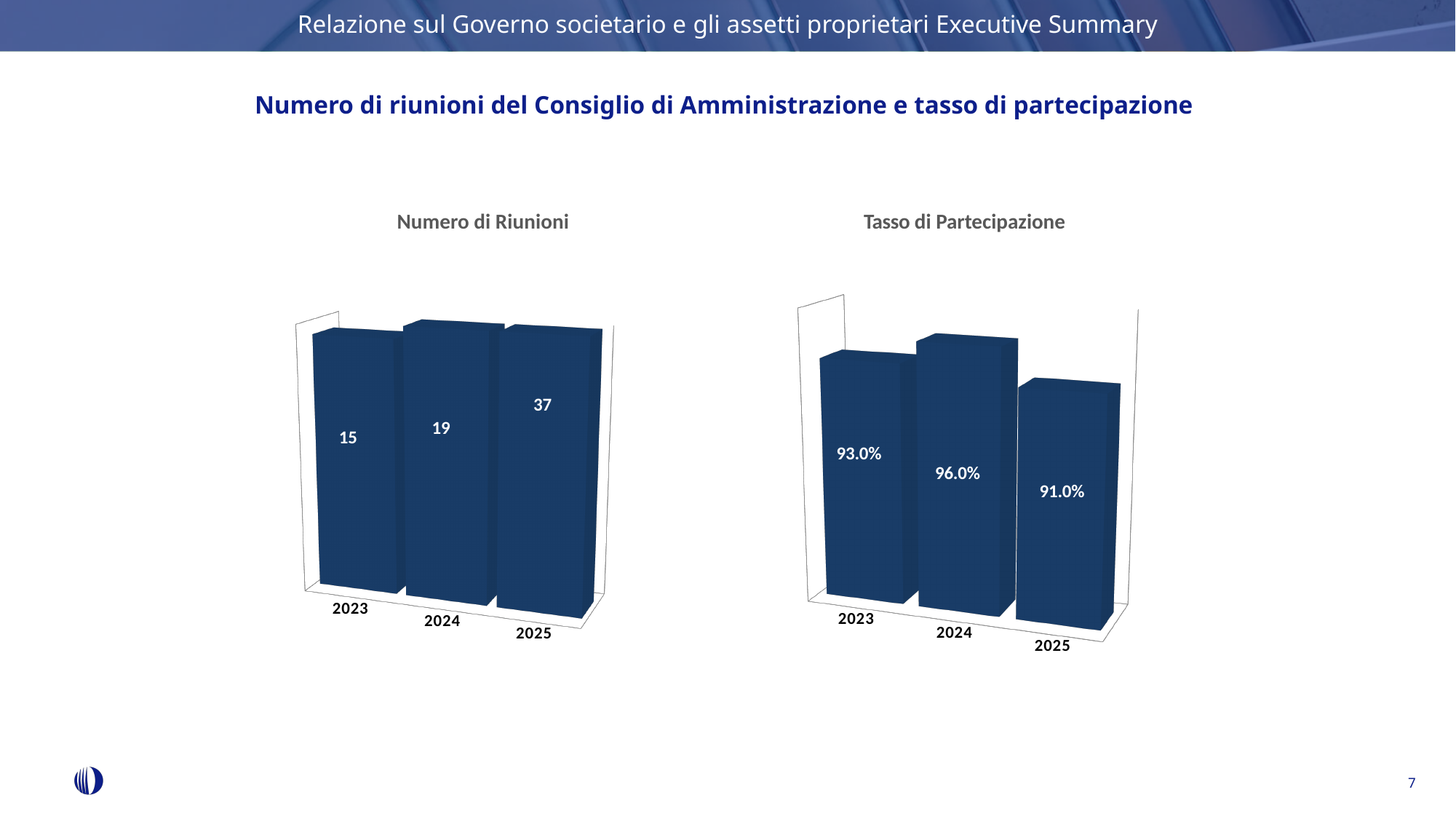
In the 'Numero di Riunioni' chart, what is the difference between the values for 2025 and 2024? 18 In the 'Tasso di Partecipazione' chart, what is the difference between the values for 2024 and 2023? 3.0% In the 'Numero di Riunioni' chart, do the values rise or fall from 2023 to 2025? Rise In the 'Tasso di Partecipazione' chart, what is the value for 2025? 91.0% In the 'Numero di Riunioni' chart, which year has the highest value? 2025 In the 'Tasso di Partecipazione' chart, what is the value for 2024? 96.0% How many years are shown in the 'Numero di Riunioni' chart? 3 In the 'Numero di Riunioni' chart, what is the value for 2023? 15 What kind of chart is the 'Tasso di Partecipazione' chart? Bar chart In the 'Tasso di Partecipazione' chart, which year has the lowest value? 2025 In the 'Numero di Riunioni' chart, what is the value for 2025? 37 In the 'Tasso di Partecipazione' chart, which is larger, the value for 2023 or the value for 2025? 2023